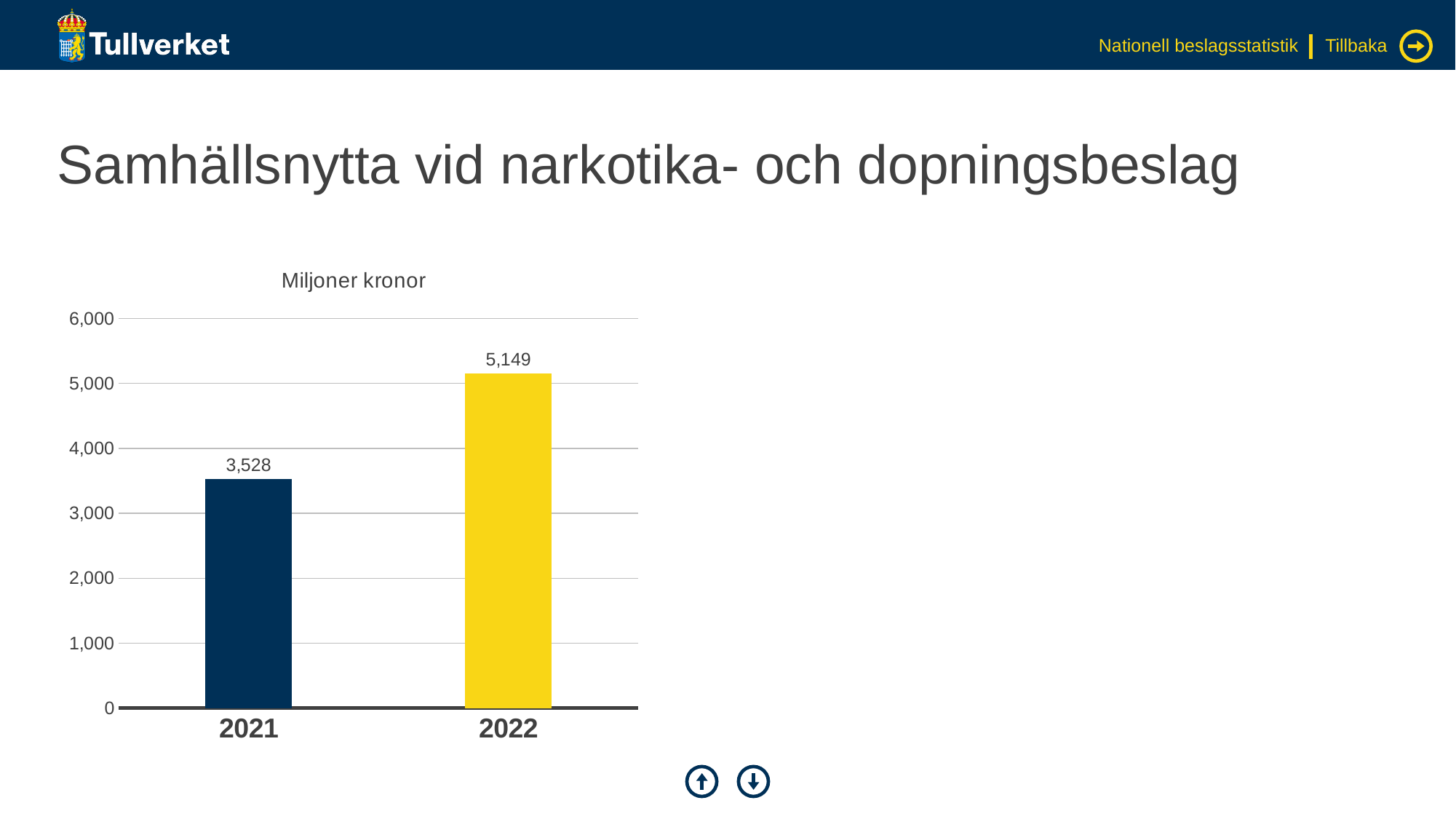
Is the value for 2022 greater or less than 5,000? greater Do the values rise or fall from 2021 to 2022? rise What kind of chart is shown on the slide? bar chart Which is larger, the value for 2021 or the value for 2022? 2022 How many bars are shown in the chart? 2 Is the value for 2021 greater or less than 4,000? less What is the value for 2022? 5,149 Which year has the lowest value? 2021 Which year has the highest value? 2022 What is the value for 2021? 3,528 What is the difference between the values for 2022 and 2021? 1,621 What unit is shown above the chart's y axis? Miljoner kronor